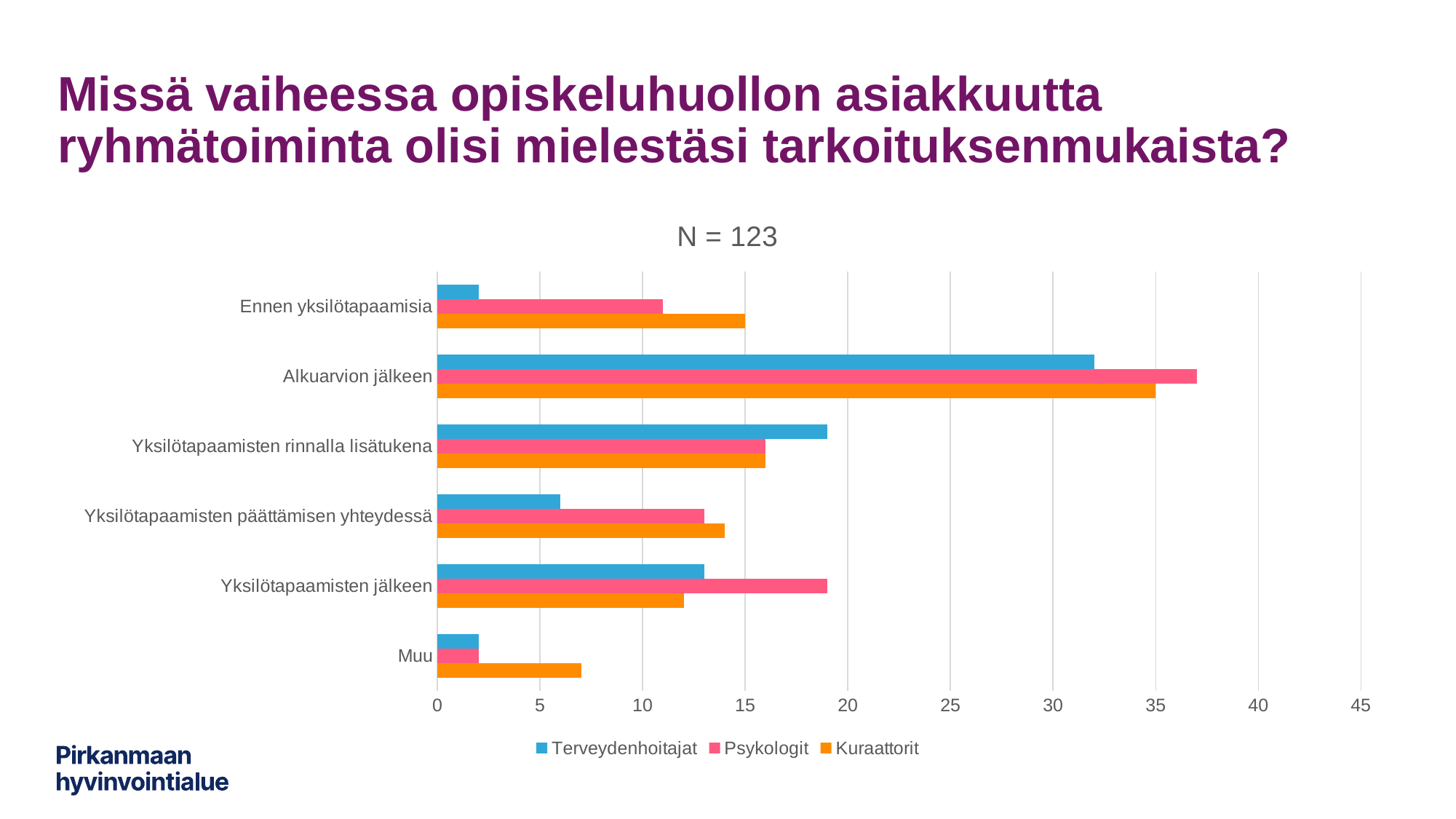
What is the value for Kuraattorit in the category Ennen yksilötapaamisia? 15 What kind of chart is shown on the slide? Bar chart How many series does the legend list? 3 Is the value for Terveydenhoitajat in the category Alkuarvion jälkeen greater or less than 30? greater Is the value for Kuraattorit in the category Muu greater or less than 5? greater Is the value for Terveydenhoitajat in the category Ennen yksilötapaamisia greater or less than 5? less What is the value for Kuraattorit in the category Alkuarvion jälkeen? 35 In the category Alkuarvion jälkeen, which is larger: the value for Psykologit or the value for Terveydenhoitajat? Psykologit Which category has the highest value for Psykologit? Alkuarvion jälkeen How many categories are shown on the vertical axis of the chart? 6 What sample size (N) is stated above the chart? N = 123 Which category has the lowest value for Kuraattorit? Muu